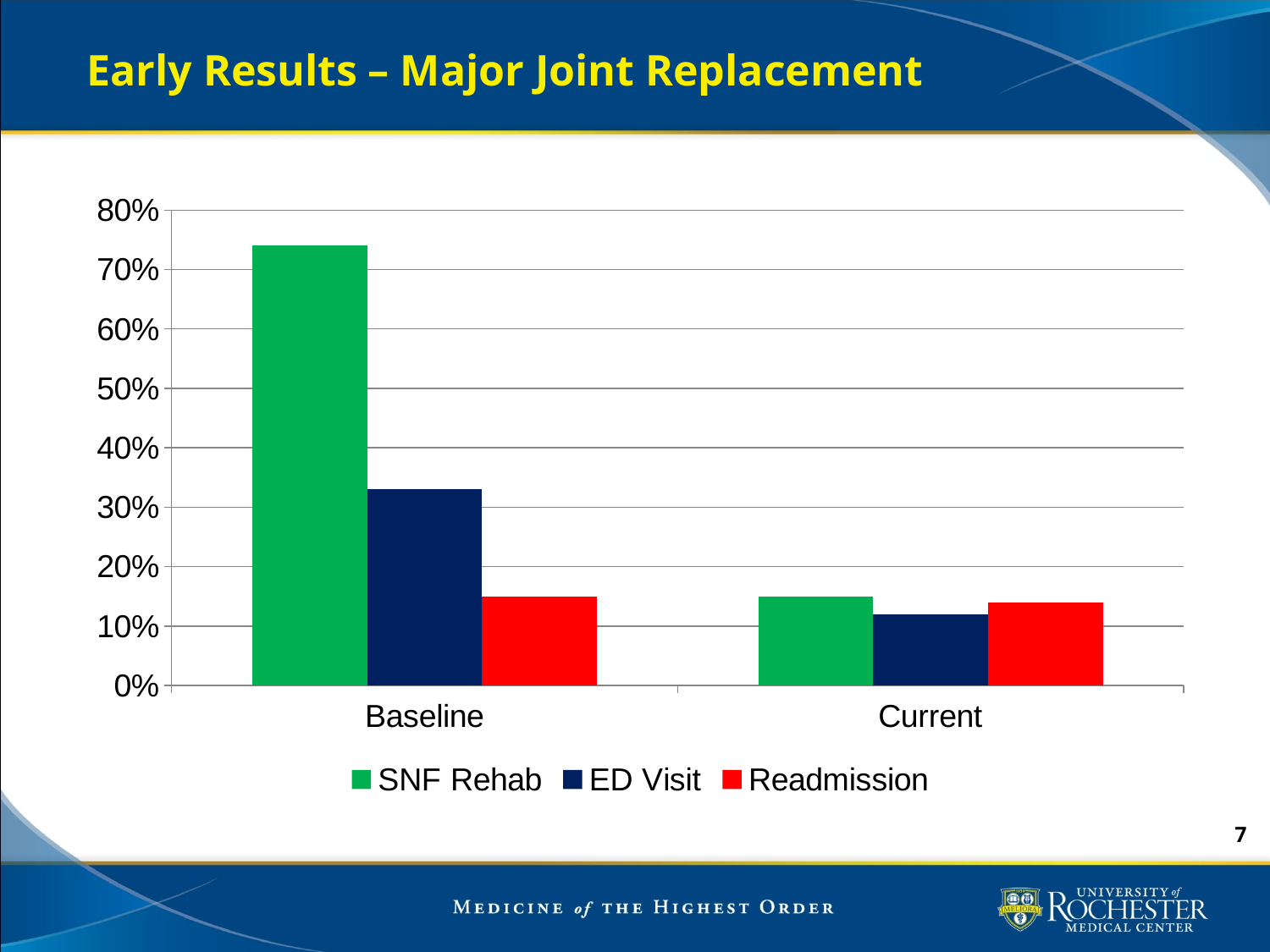
What colour represents the Readmission series? red Which is larger: SNF Rehab at Baseline or SNF Rehab at Current? SNF Rehab at Baseline Which series has the highest value in the Baseline category? SNF Rehab Is the value for ED Visit at Baseline greater or less than 30%? greater Is the value for SNF Rehab in the Current category greater or less than 20%? less How many series does the legend list? 3 Is the value for ED Visit in the Current category greater or less than 10%? greater Does the SNF Rehab value rise or fall from Baseline to Current? fall What kind of chart is shown on the slide? bar chart Which series has the lowest value in the Baseline category? Readmission How many categories are shown on the x axis? 2